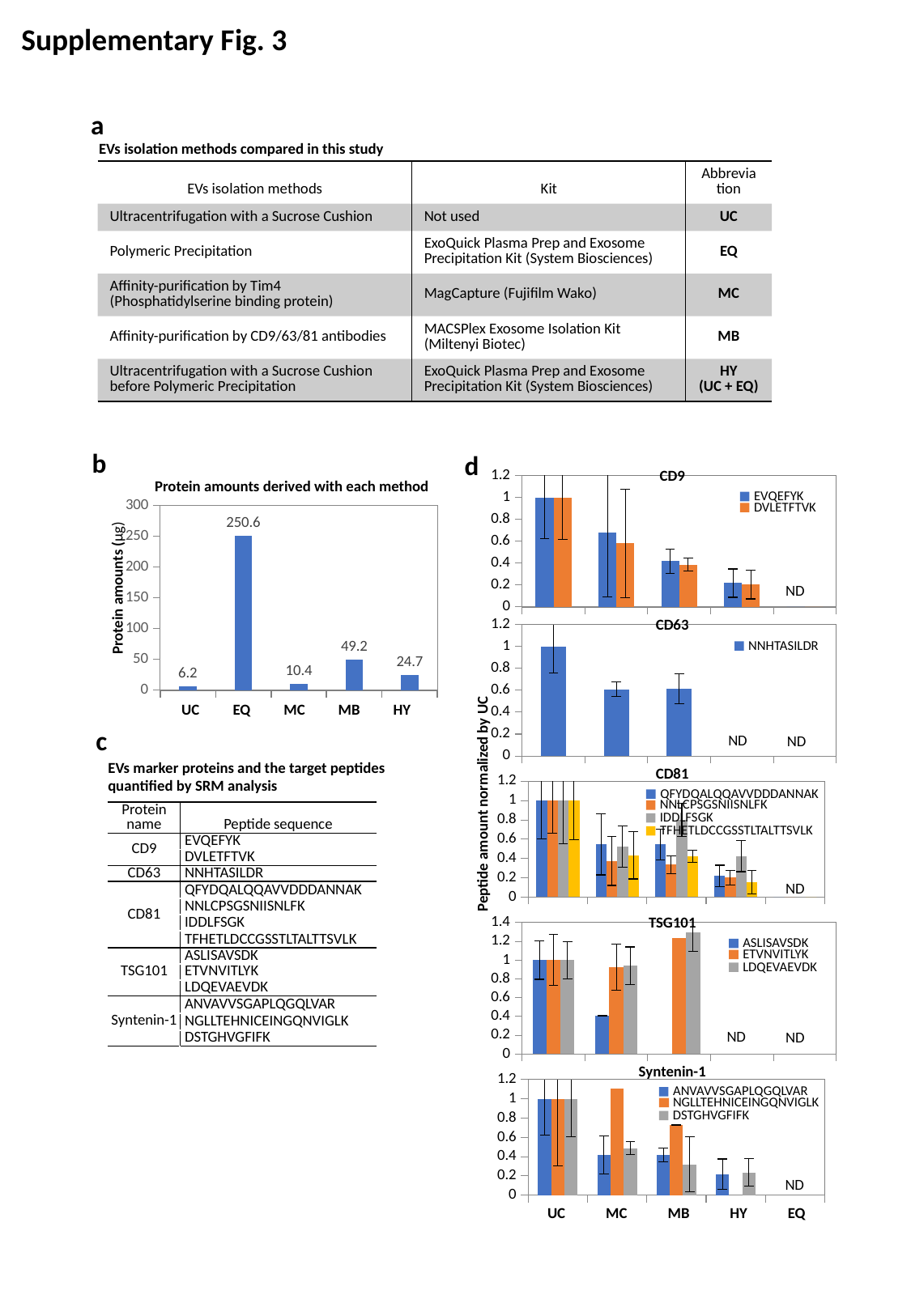
In the chart titled 'Protein amounts derived with each method', which method has the highest protein amount? EQ In the CD63 chart in panel d, is the NNHTASILDR value for MC greater or less than 0.8? less In the chart titled 'Protein amounts derived with each method', what is the protein amount for EQ? 250.6 In the chart titled 'Protein amounts derived with each method', which method has the lowest protein amount? UC In the chart titled 'Protein amounts derived with each method', what is the protein amount for MB? 49.2 In the TSG101 chart in panel d, is the ASLISAVSDK value for MC greater or less than 0.6? less In the CD9 chart in panel d, how many peptide series does the legend list? 2 In the chart titled 'Protein amounts derived with each method', how many methods are shown on the x axis? 5 In the chart titled 'Protein amounts derived with each method', which has a larger protein amount, MB or HY? MB In the chart titled 'Protein amounts derived with each method', what is the difference between the protein amounts for EQ and UC? 244.4 In the CD81 chart in panel d, how many peptide series does the legend list? 4 What kind of chart is 'Protein amounts derived with each method'? bar chart